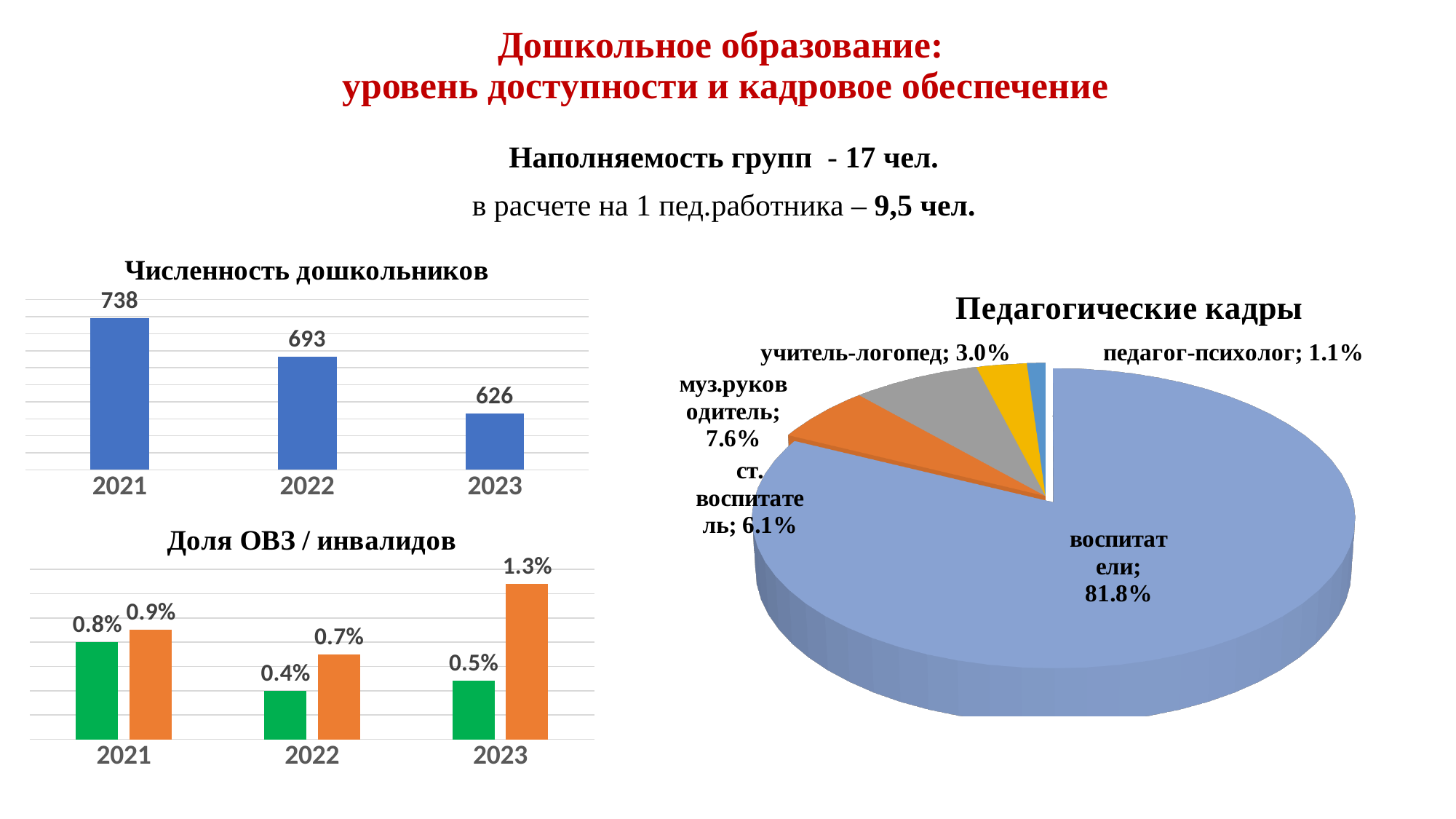
In the chart 'Доля ОВЗ / инвалидов', what is the value of the orange bar for 2023? 1.3% In the chart 'Педагогические кадры', what share of the pie is 'воспитатели'? 81.8% What kind of chart is 'Педагогические кадры'? pie chart In the chart 'Доля ОВЗ / инвалидов', which is larger for 2021: the green bar or the orange bar? the orange bar In the chart 'Численность дошкольников', what is the value for 2021? 738 In the chart 'Педагогические кадры', which category has the smallest share? педагог-психолог What kind of chart is 'Численность дошкольников'? bar chart In the chart 'Доля ОВЗ / инвалидов', what is the value of the green bar for 2022? 0.4% In the chart 'Численность дошкольников', which year has the lowest value? 2023 In the chart 'Численность дошкольников', how many years are shown? 3 In the chart 'Численность дошкольников', what is the difference between the values for 2021 and 2023? 112 In the chart 'Численность дошкольников', do the values rise or fall from 2021 to 2023? fall